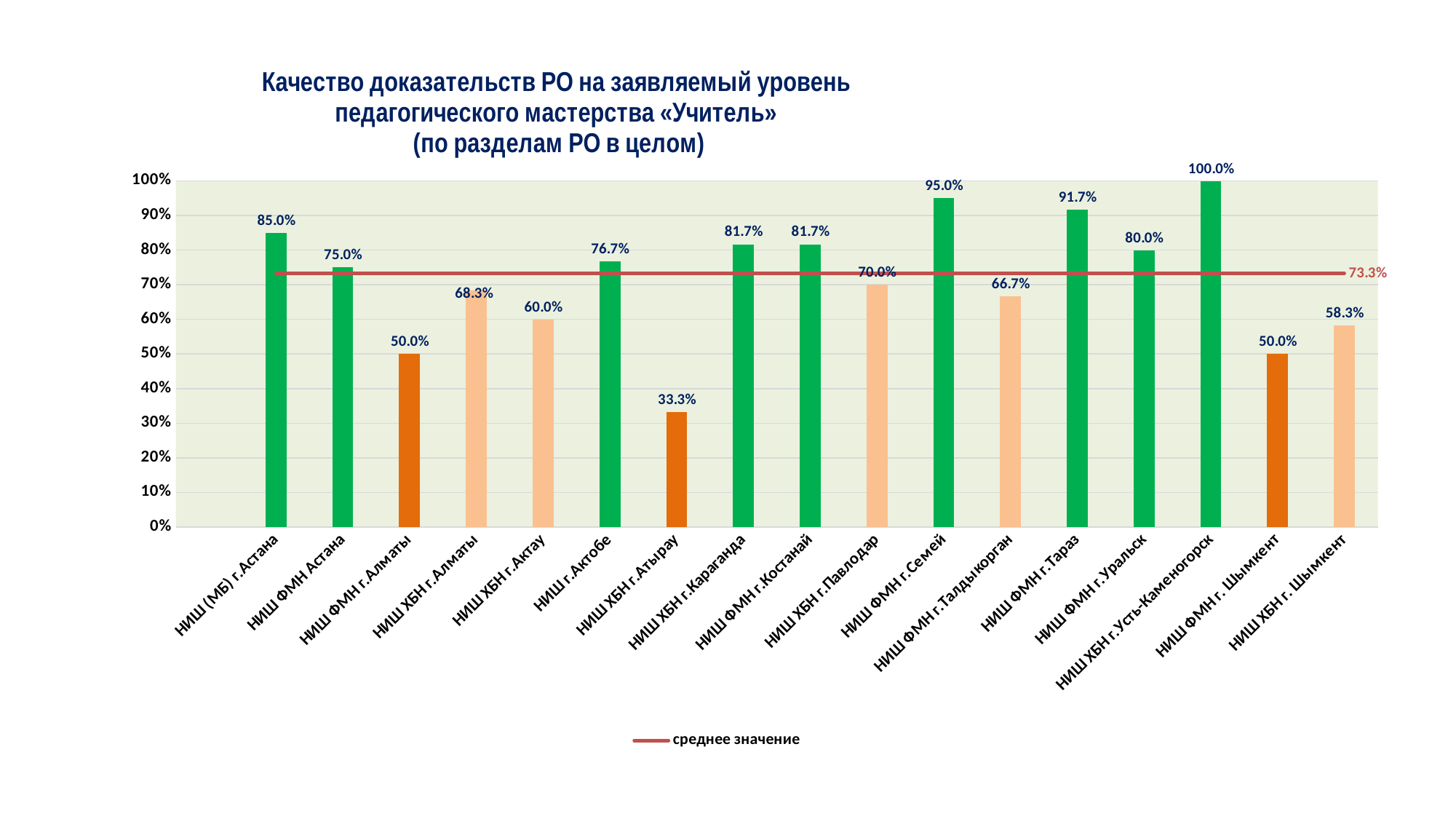
Which category has the highest value? НИШ ХБН г.Усть-Каменогорск What kind of chart is this? bar chart Which is larger, the value for НИШ ФМН г.Тараз or the value for НИШ ФМН г.Уральск? НИШ ФМН г.Тараз What is the value for НИШ ХБН г.Атырау? 33.3% Which category has the lowest value? НИШ ХБН г.Атырау Is the value for НИШ ХБН г.Павлодар greater or less than the average line value of 73.3%? less What is the difference between the values for НИШ (МБ) г.Астана and НИШ ФМН Астана? 10.0% What is the label of the line shown in the legend? среднее значение How many categories (bars) are shown on the chart? 17 What is the value for НИШ ФМН г.Семей? 95.0% What value does the average line (среднее значение) show? 73.3% What is the value for НИШ ФМН г.Талдыкорган? 66.7%